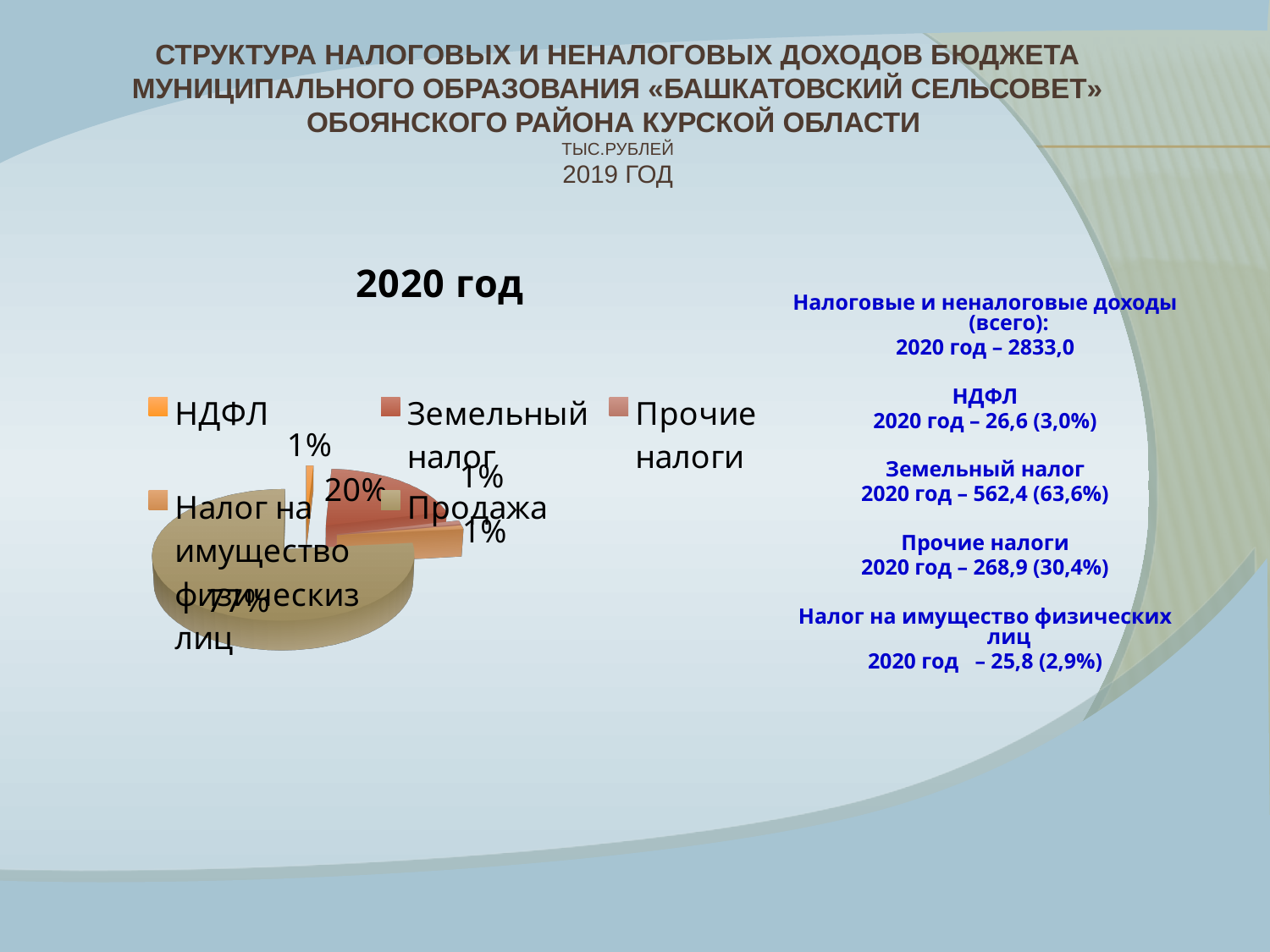
What is the smallest percentage label shown on the pie chart? 1% What is the largest percentage label shown on the pie chart? 77% What kind of chart is shown on the slide? pie chart What is the second-largest percentage label shown on the pie chart? 20% What is the title of the pie chart? 2020 год Which entry appears first in the legend of the pie chart? НДФЛ How many slices of the pie chart are labelled 1%? 3 How many entries does the legend of the pie chart list? 5